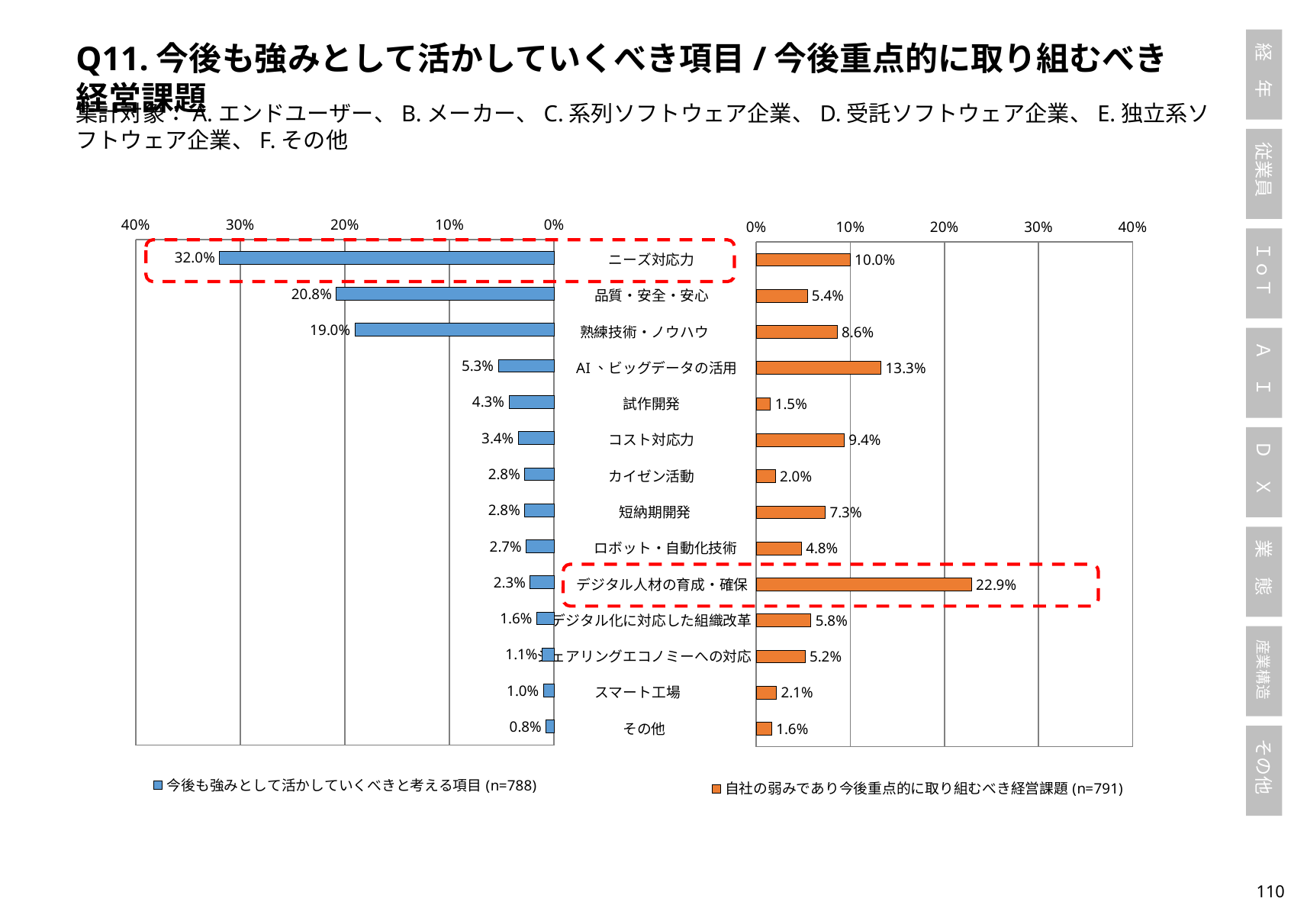
In the left chart, which category has the highest value? ニーズ対応力 In the right chart, which category has the lowest value? 試作開発 In the right chart, which category has the highest value? デジタル人材の育成・確保 What kind of chart is the right chart? bar chart In the left chart, what is the difference between the values for ニーズ対応力 and 品質・安全・安心? 11.2% How many categories are plotted in the left chart? 14 What is the sample size (n) shown in the legend of the left chart? n=788 In the right chart (自社の弱みであり今後重点的に取り組むべき経営課題), what is the value for デジタル人材の育成・確保? 22.9% In the left chart (今後も強みとして活かしていくべきと考える項目), what is the value for ニーズ対応力? 32.0% In the right chart, which is larger: the value for コスト対応力 or the value for 短納期開発? コスト対応力 In the left chart, is the value for 熟練技術・ノウハウ greater or less than 10%? greater In the right chart, what is the value for AI、ビッグデータの活用? 13.3%